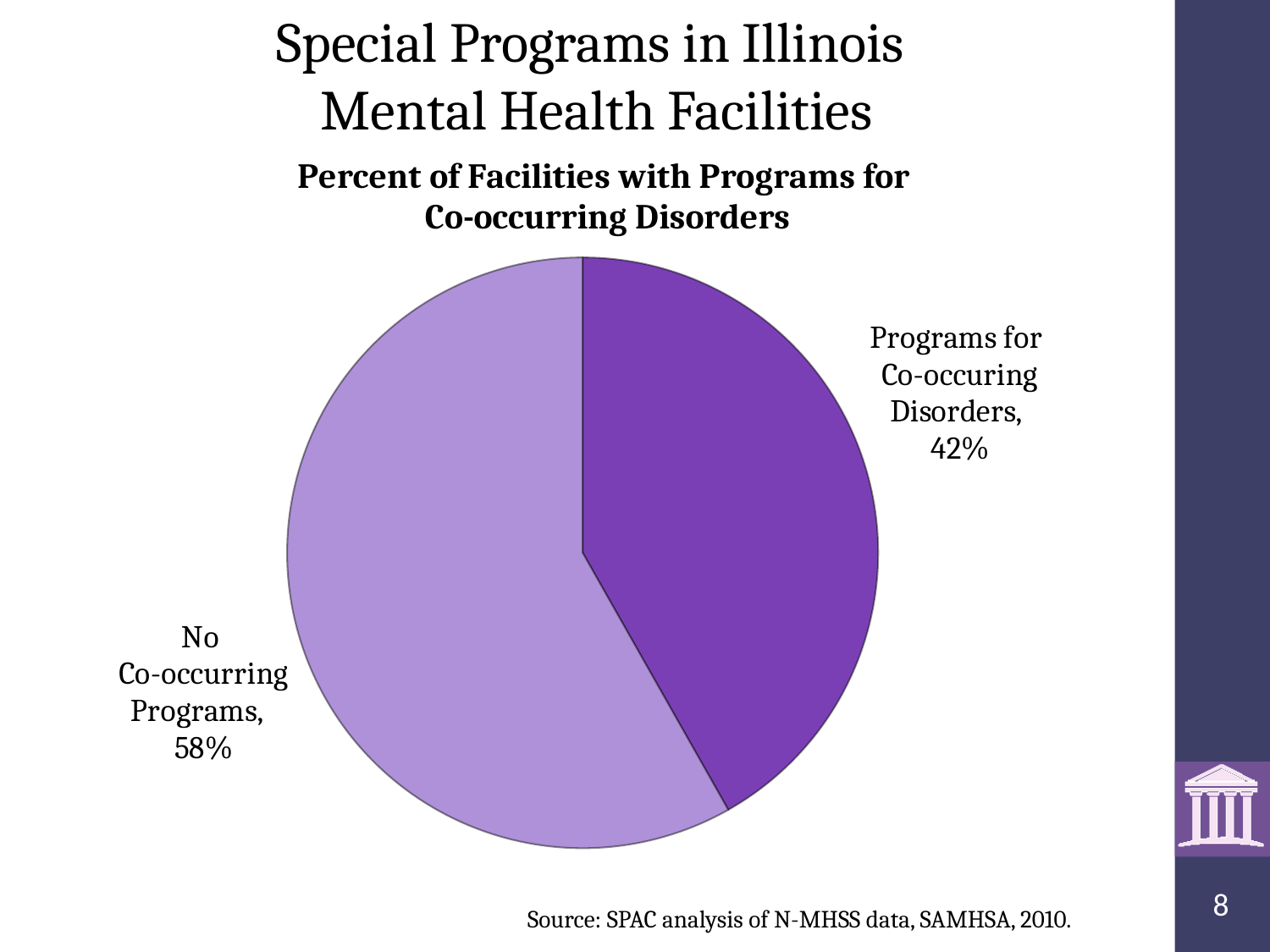
What kind of chart is shown on the slide? pie chart Which slice is the largest? No Co-occurring Programs What percentage of facilities have no co-occurring programs? 58% What is the difference in percentage points between facilities with no co-occurring programs and those with programs for co-occurring disorders? 16 Which slice is the smallest? Programs for Co-occuring Disorders What percentage of facilities have programs for co-occurring disorders? 42% What is the source cited for the chart data? SPAC analysis of N-MHSS data, SAMHSA, 2010. How many slices does the pie chart have? 2 Is the share of facilities with programs for co-occurring disorders greater or less than 50%? less What is the title of the chart? Percent of Facilities with Programs for Co-occurring Disorders Which is larger: the share of facilities with programs for co-occurring disorders or the share with no co-occurring programs? No Co-occurring Programs